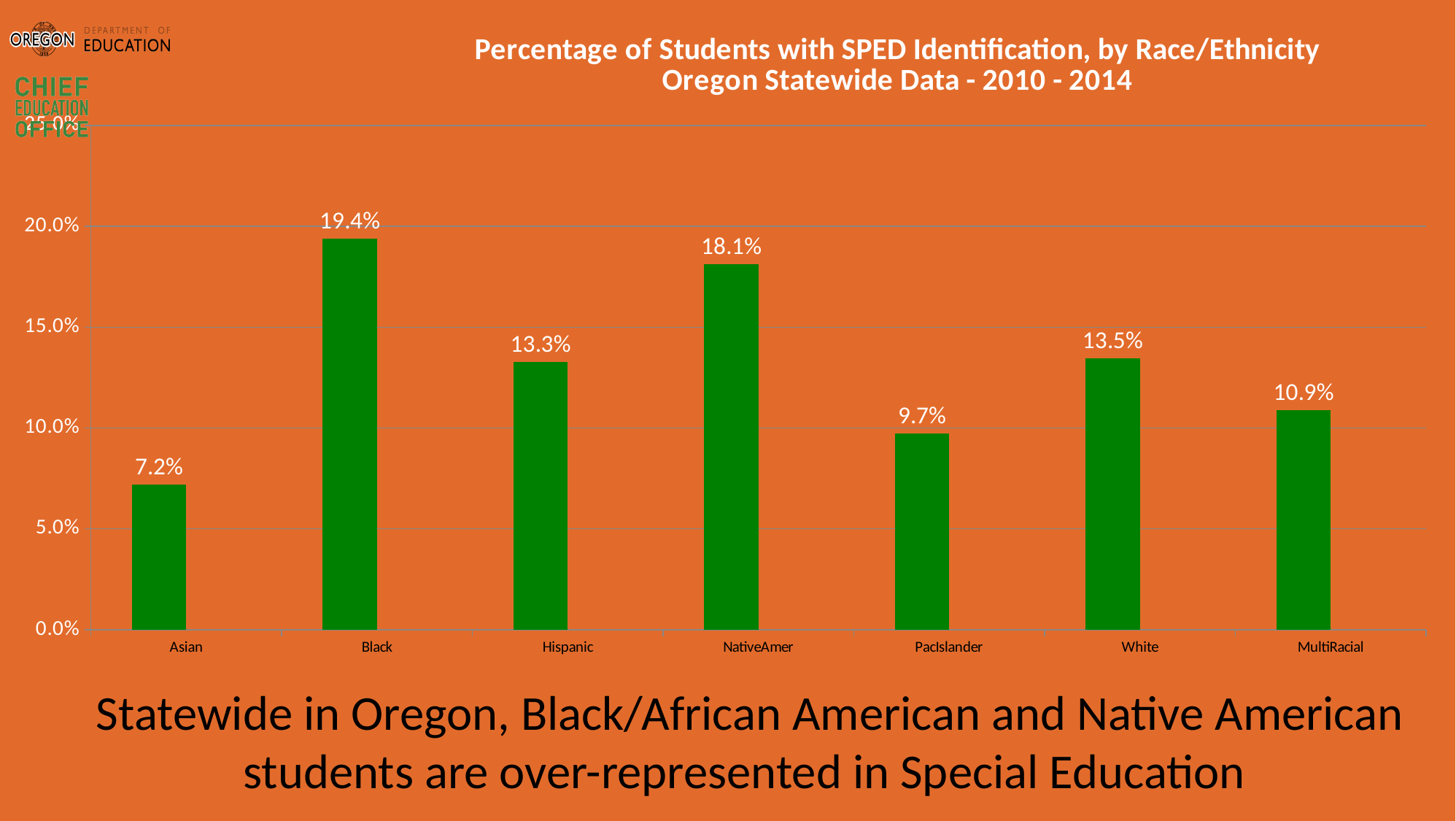
What is the value shown for PacIslander? 9.7% What is the difference between the Black and Asian percentages? 12.2% Which race/ethnicity category has the highest percentage of SPED identification? Black How many race/ethnicity categories are shown on the chart? 7 Is the value for NativeAmer greater or less than 15.0%? greater What years does the chart title say the Oregon statewide data covers? 2010 - 2014 What is the difference between the NativeAmer and White percentages? 4.6% Which is larger, the value for Hispanic or the value for MultiRacial? Hispanic What is the percentage of students with SPED identification for Asian students? 7.2% Which race/ethnicity category has the lowest percentage of SPED identification? Asian What is the percentage of students with SPED identification for Black students? 19.4% What kind of chart is shown on the slide? Bar chart